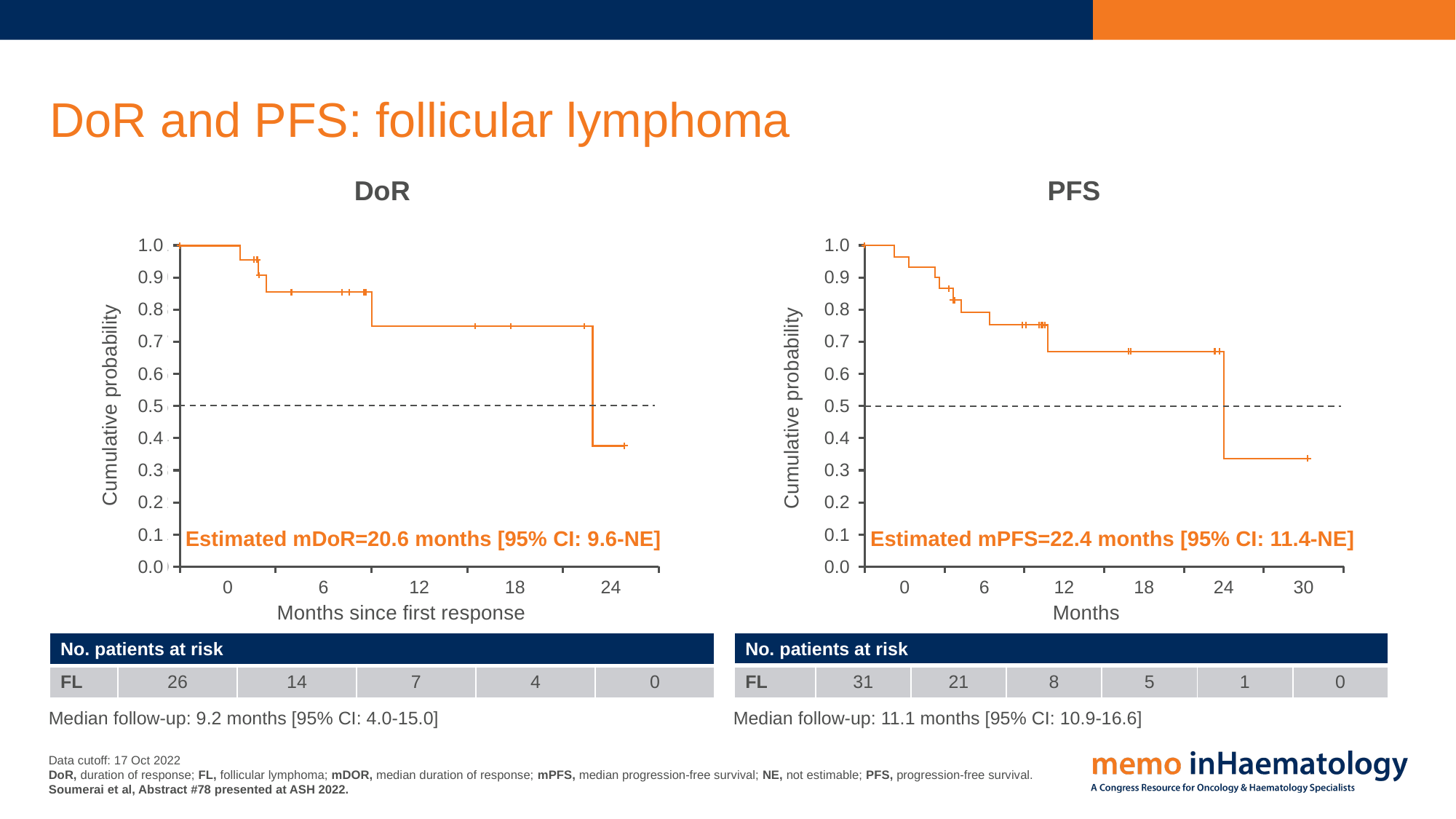
On the PFS chart, how many time points are listed in the 'No. patients at risk' table? 6 On the DoR chart, what is the estimated median duration of response (mDoR)? 20.6 months On the PFS chart, how many FL patients are at risk at 0 months? 31 On the DoR chart, how many FL patients are at risk at 12 months? 7 On the DoR chart, does the cumulative probability rise or fall as months since first response increase? fall On the PFS chart, how many FL patients are at risk at 24 months? 1 Which estimated median is larger, the mDoR on the DoR chart or the mPFS on the PFS chart? mPFS On the DoR chart, is the cumulative probability at 12 months greater or less than 0.5? greater On the DoR chart, how many FL patients are at risk at 0 months? 26 How many more patients are at risk at 0 months on the PFS chart than on the DoR chart? 5 On the PFS chart, what is the estimated median progression-free survival (mPFS)? 22.4 months On the PFS chart, is the cumulative probability at 30 months greater or less than 0.5? less